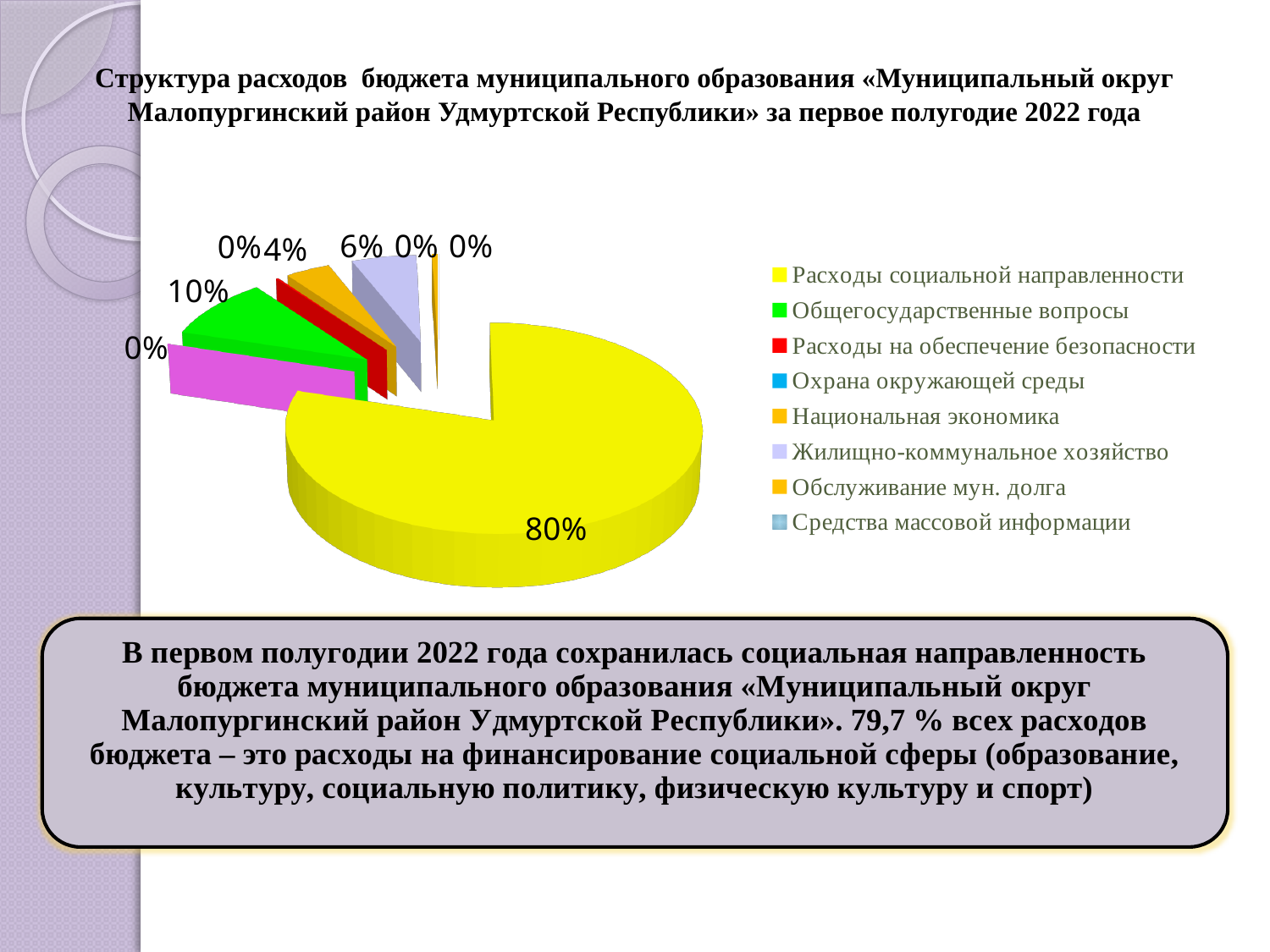
Which is larger: the share for Расходы социальной направленности or the share for Общегосударственные вопросы? Расходы социальной направленности What share of the pie is labelled for Общегосударственные вопросы (the green slice)? 10% What colour is the largest slice of the pie chart? yellow How many entries does the legend of the pie chart list? 8 By how many percentage points does the share for Расходы социальной направленности exceed the share for Общегосударственные вопросы? 70 Which category has the largest share of the pie? Расходы социальной направленности What kind of chart is shown on the slide? pie chart What is the first entry listed in the legend of the pie chart? Расходы социальной направленности What share of the pie is labelled for Расходы социальной направленности? 80%